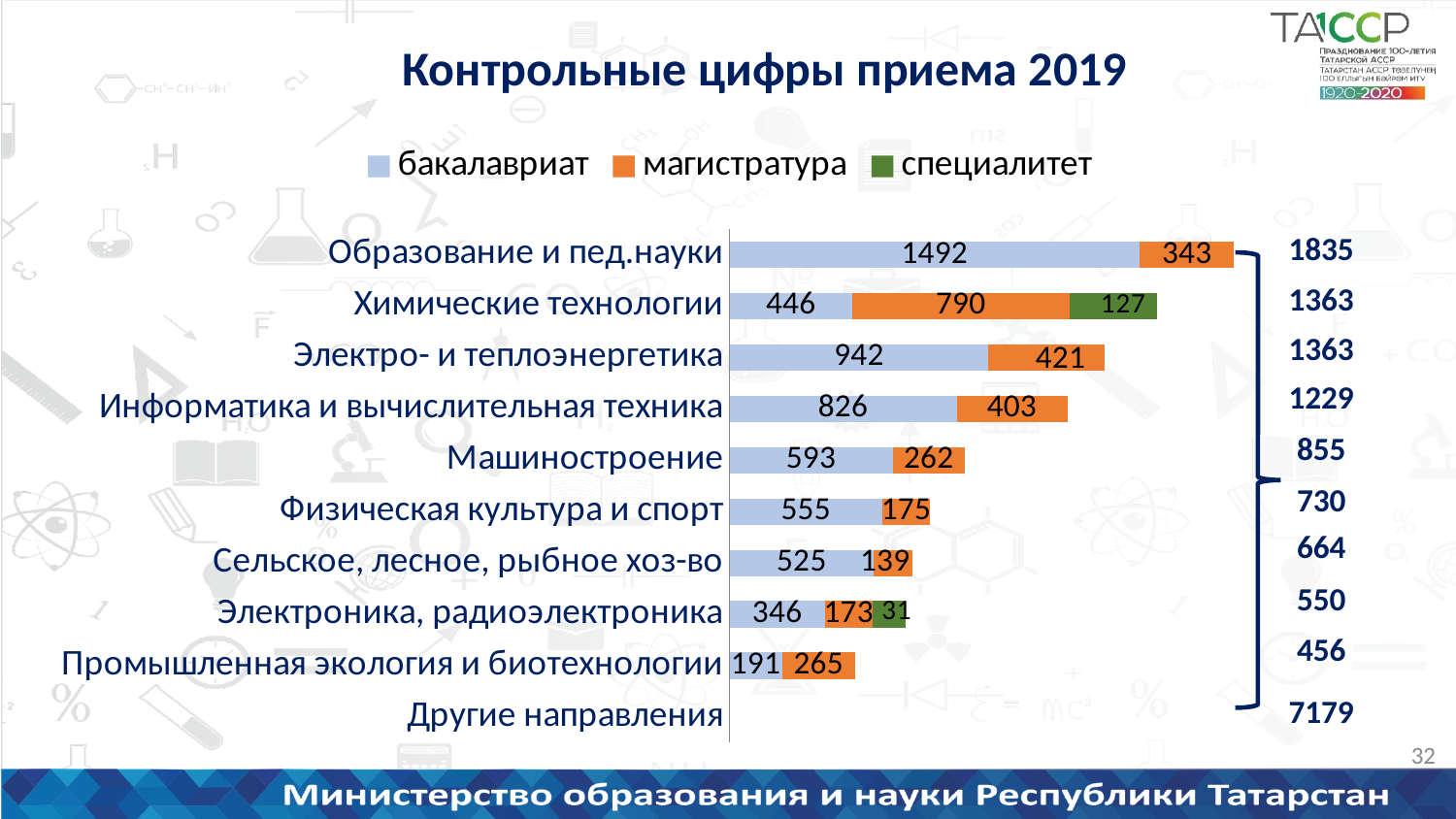
What is the магистратура value for Машиностроение? 262 Which category has the highest бакалавриат value? Образование и пед.науки What type of chart is shown on the slide? Stacked bar chart How many series does the legend list? 3 What is the total of the stacked bar for Химические технологии? 1363 What is the бакалавриат value for Химические технологии? 446 Which category has the lowest бакалавриат value among the plotted bars? Промышленная экология и биотехнологии Which category has the highest магистратура value? Химические технологии What is the специалитет value for Электроника, радиоэлектроника? 31 Which has the larger магистратура value: Электро- и теплоэнергетика or Информатика и вычислительная техника? Электро- и теплоэнергетика How many categories have a специалитет segment in their bar? 2 What is the difference between the бакалавриат and магистратура values for Образование и пед.науки? 1149